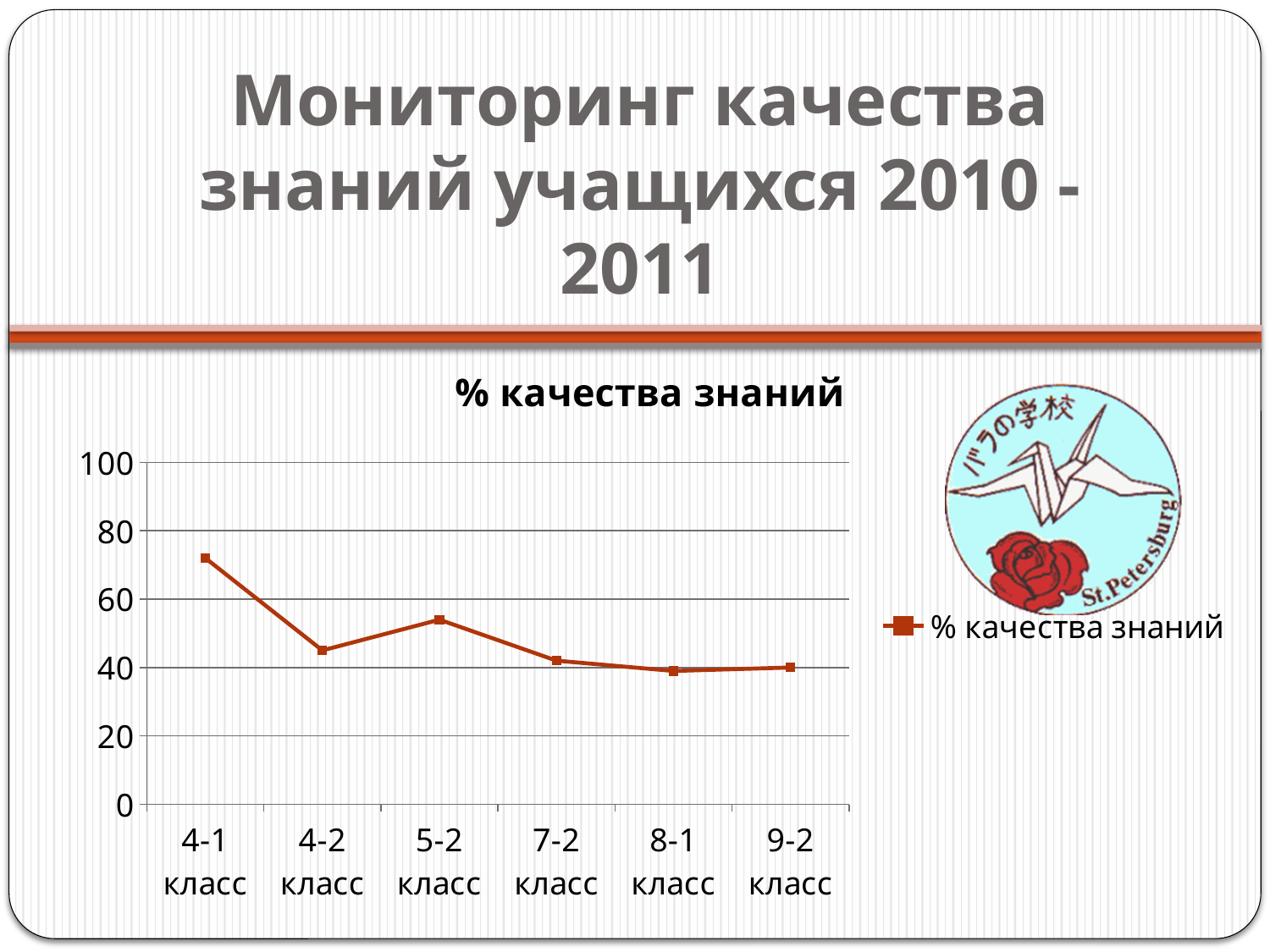
What kind of chart is shown on the slide? line chart Which has a higher % качества знаний, 5-2 класс or 7-2 класс? 5-2 класс Which has a higher % качества знаний, 4-1 класс or 4-2 класс? 4-1 класс How many series does the legend list? 1 Is the value for 7-2 класс greater or less than 60? less What is the title of the chart? % качества знаний Is the value for 9-2 класс greater or less than 60? less Is the value for 4-1 класс greater or less than 60? greater How many classes are plotted along the x axis? 6 Which class has the highest % качества знаний? 4-1 класс Overall, does the % качества знаний rise or fall from 4-1 класс to 9-2 класс? fall